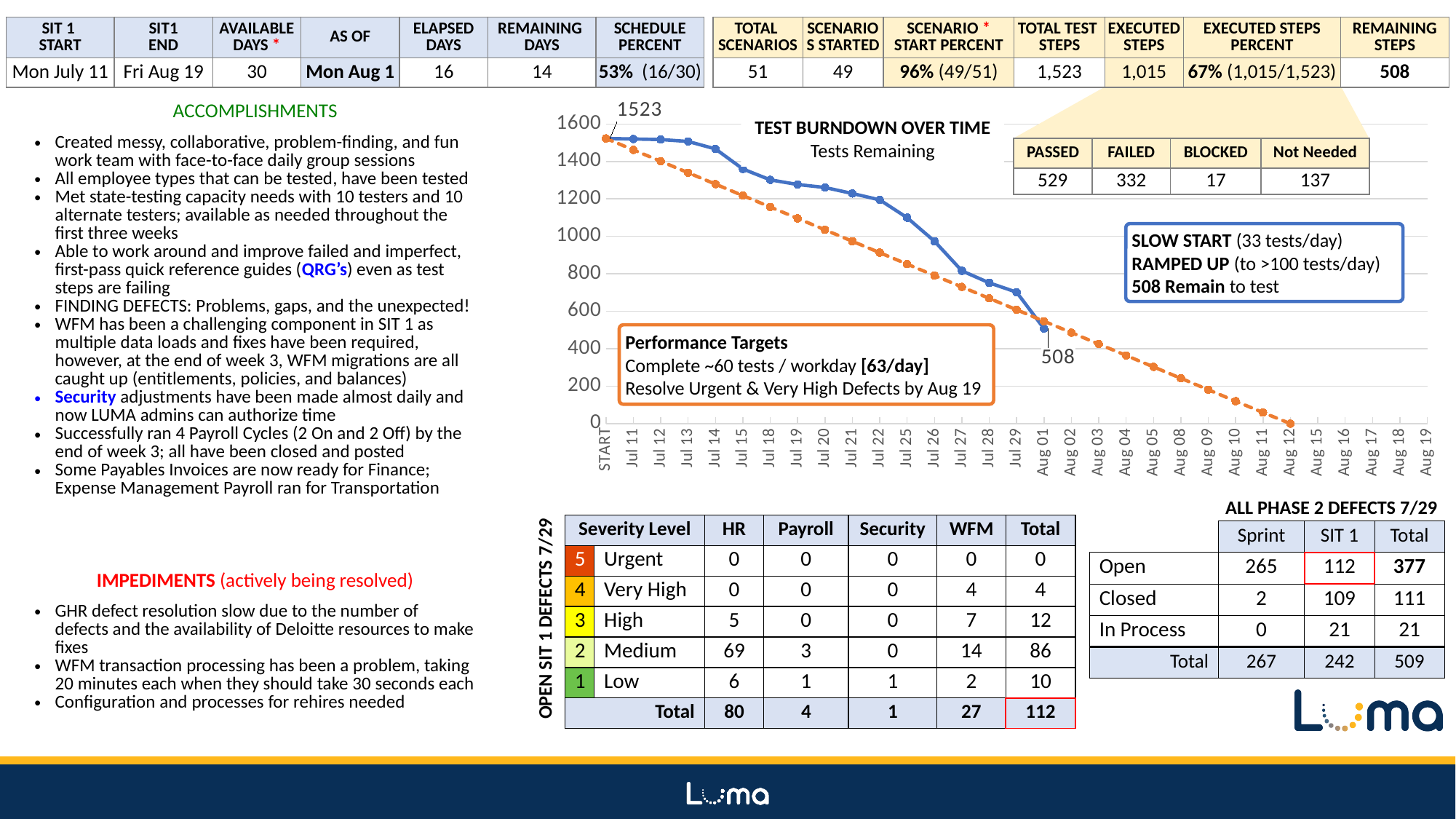
In the TEST BURNDOWN OVER TIME chart, is the solid line's value on Jul 29 greater or less than 800? less In the TEST BURNDOWN OVER TIME chart, on which date does the dashed line reach 0? Aug 12 In the TEST BURNDOWN OVER TIME chart, which has the larger value on the solid line: Jul 15 or Jul 29? Jul 15 In the TEST BURNDOWN OVER TIME chart, what is the value of tests remaining at START? 1523 In the TEST BURNDOWN OVER TIME chart, what is the difference between the tests remaining at START and on Aug 01? 1015 What is the highest value shown on the y axis of the TEST BURNDOWN OVER TIME chart? 1600 In the TEST BURNDOWN OVER TIME chart, is the solid line's value on Jul 15 greater or less than 1200? greater What is the subtitle shown under the title of the TEST BURNDOWN OVER TIME chart? Tests Remaining In the TEST BURNDOWN OVER TIME chart, do the tests remaining rise or fall over time along the x axis? fall In the TEST BURNDOWN OVER TIME chart, is the solid line's value on Jul 25 greater or less than 1000? greater In the TEST BURNDOWN OVER TIME chart, what is the labelled value of tests remaining on Aug 01? 508 What kind of chart is the TEST BURNDOWN OVER TIME chart? line chart